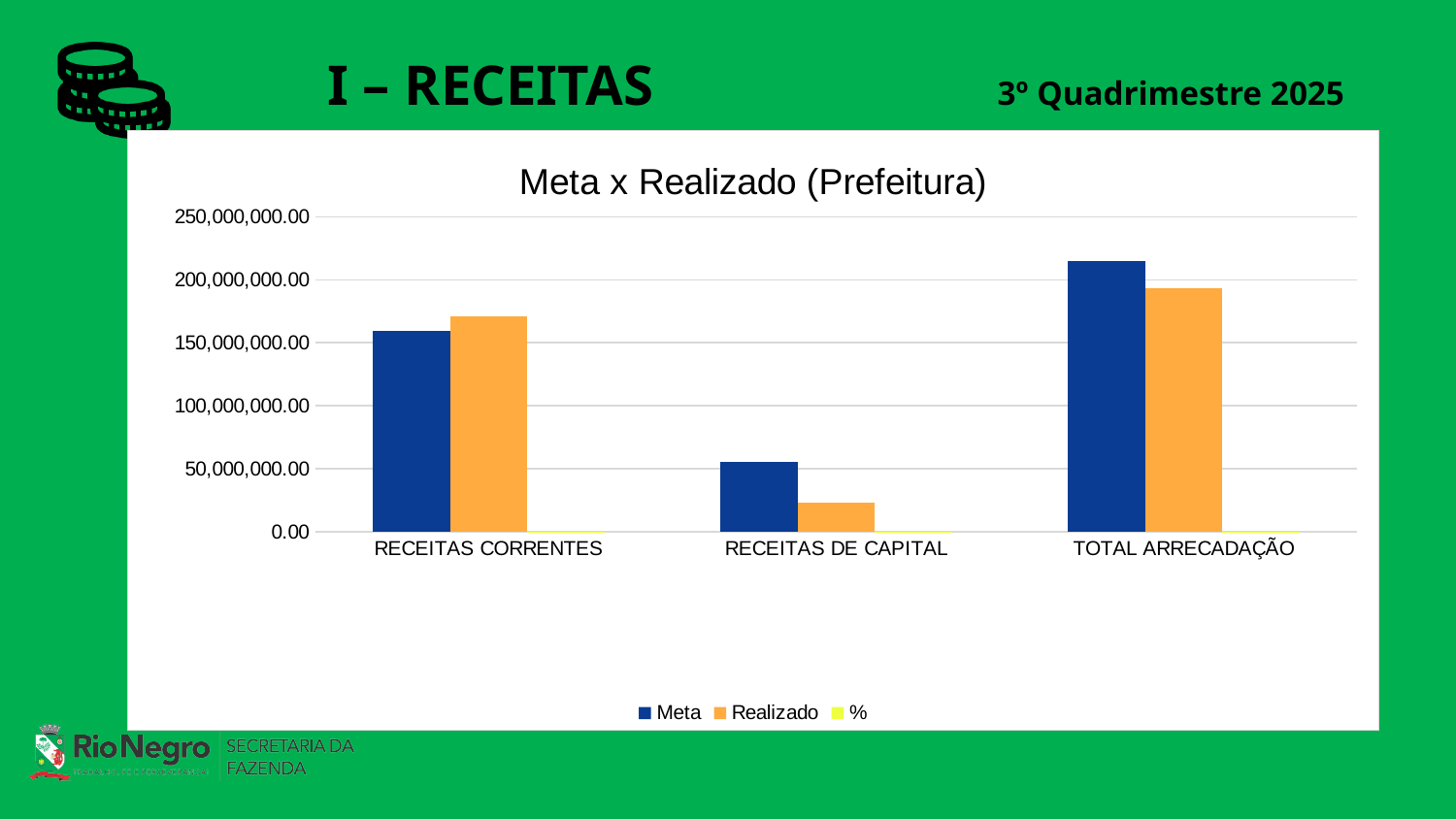
What is the title of the chart? Meta x Realizado (Prefeitura) Which category has the lowest Realizado value? RECEITAS DE CAPITAL Which category has the highest Meta value? TOTAL ARRECADAÇÃO Is the Realizado value for RECEITAS DE CAPITAL greater or less than 50,000,000.00? less For RECEITAS CORRENTES, which is larger: Meta or Realizado? Realizado Is the Realizado value for RECEITAS CORRENTES greater or less than 150,000,000.00? greater How many series does the legend list? 3 Is the Meta value for TOTAL ARRECADAÇÃO greater or less than 200,000,000.00? greater How many categories are shown on the x axis? 3 For TOTAL ARRECADAÇÃO, which is larger: Meta or Realizado? Meta Which series is shown in orange in the legend? Realizado What kind of chart is shown on the slide? bar chart